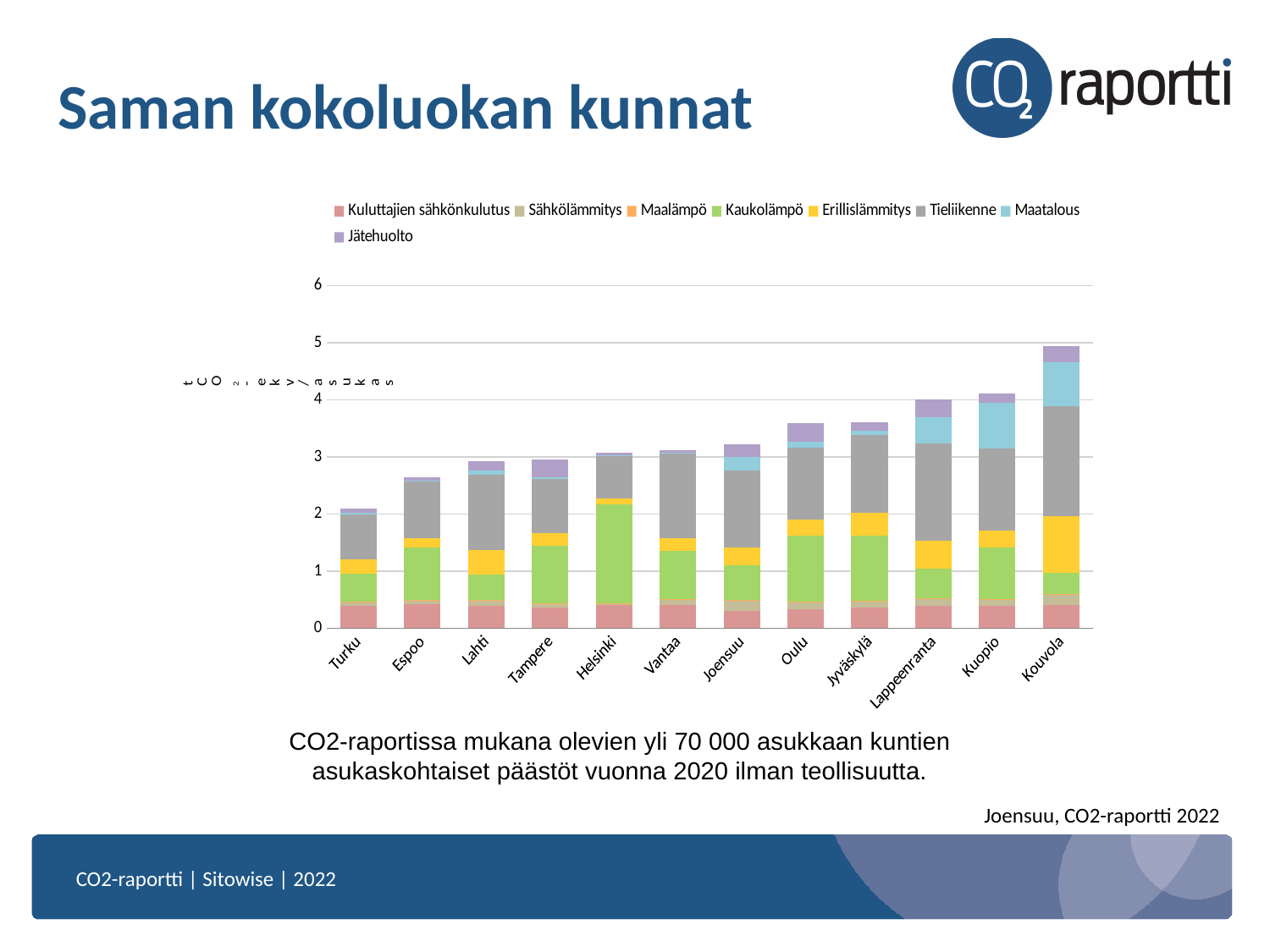
Which has a larger total bar, Oulu or Espoo? Oulu What is the first series listed in the chart's legend? Kuluttajien sähkönkulutus Which municipality has the highest total emissions per inhabitant in the chart? Kouvola Is the total value for Kouvola greater or less than 4? greater What kind of chart is shown on the slide? Stacked bar chart Is the total value for Jyväskylä greater or less than 4? less Is the total value for Oulu greater or less than 3? greater How many series does the chart's legend list? 8 Which municipality has the lowest total emissions per inhabitant in the chart? Turku Do the total bar heights generally rise or fall from left to right along the x axis? rise How many municipalities are shown on the x axis of the chart? 12